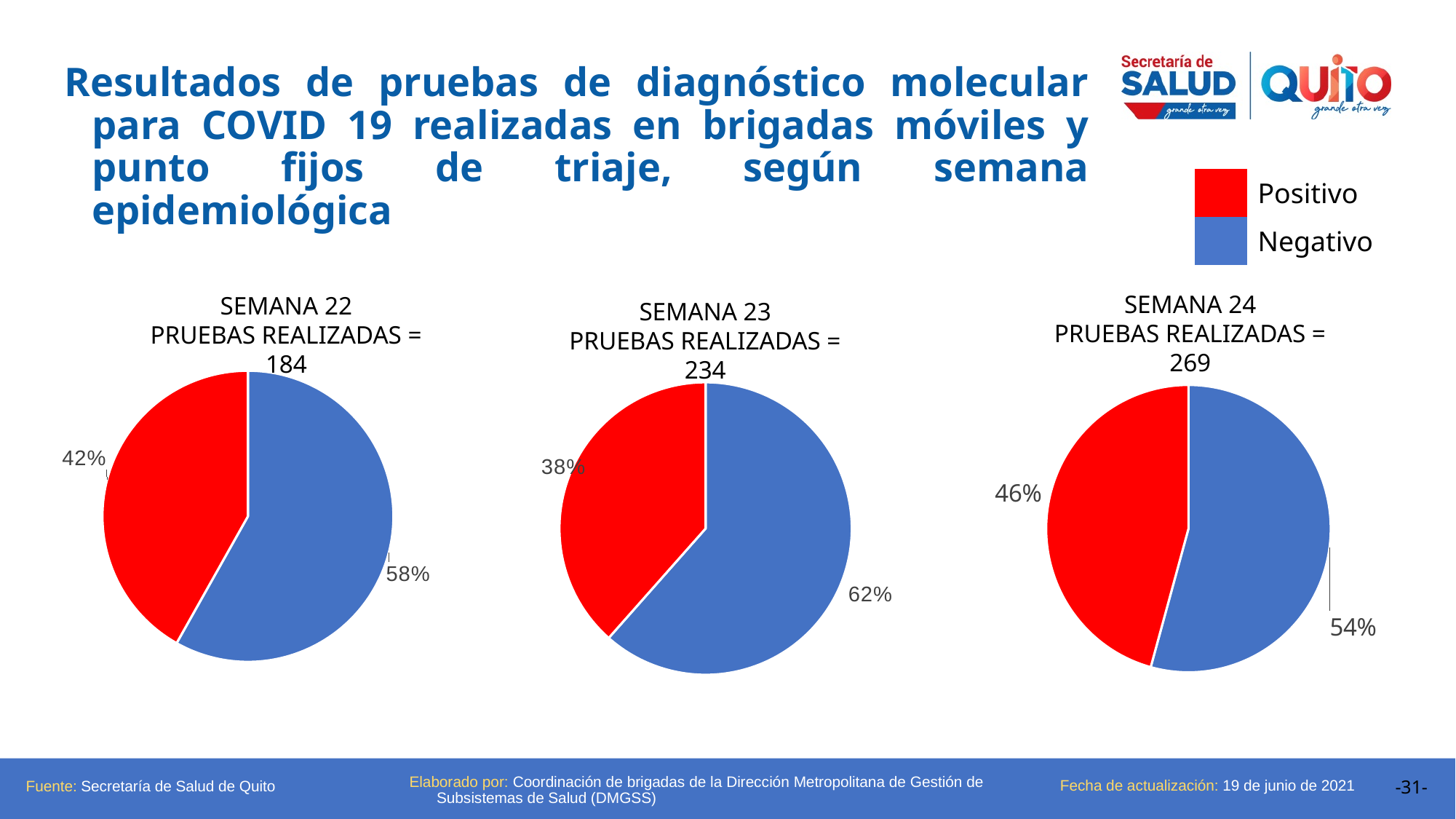
In the SEMANA 23 pie chart, what share of tests were Positivo? 38% How many tests (PRUEBAS REALIZADAS) are reported in the title of the SEMANA 23 chart? 234 In the SEMANA 24 pie chart, what share of tests were Negativo? 54% In the SEMANA 24 pie chart, what share of tests were Positivo? 46% How many tests (PRUEBAS REALIZADAS) are reported in the title of the SEMANA 24 chart? 269 Which colour represents Positivo in the legend? Red In the SEMANA 24 pie chart, what is the difference in percentage points between the Negativo and Positivo shares? 8% In the SEMANA 22 pie chart, which slice is larger, Positivo or Negativo? Negativo What kind of chart is used for each of the three weeks on the slide? Pie chart